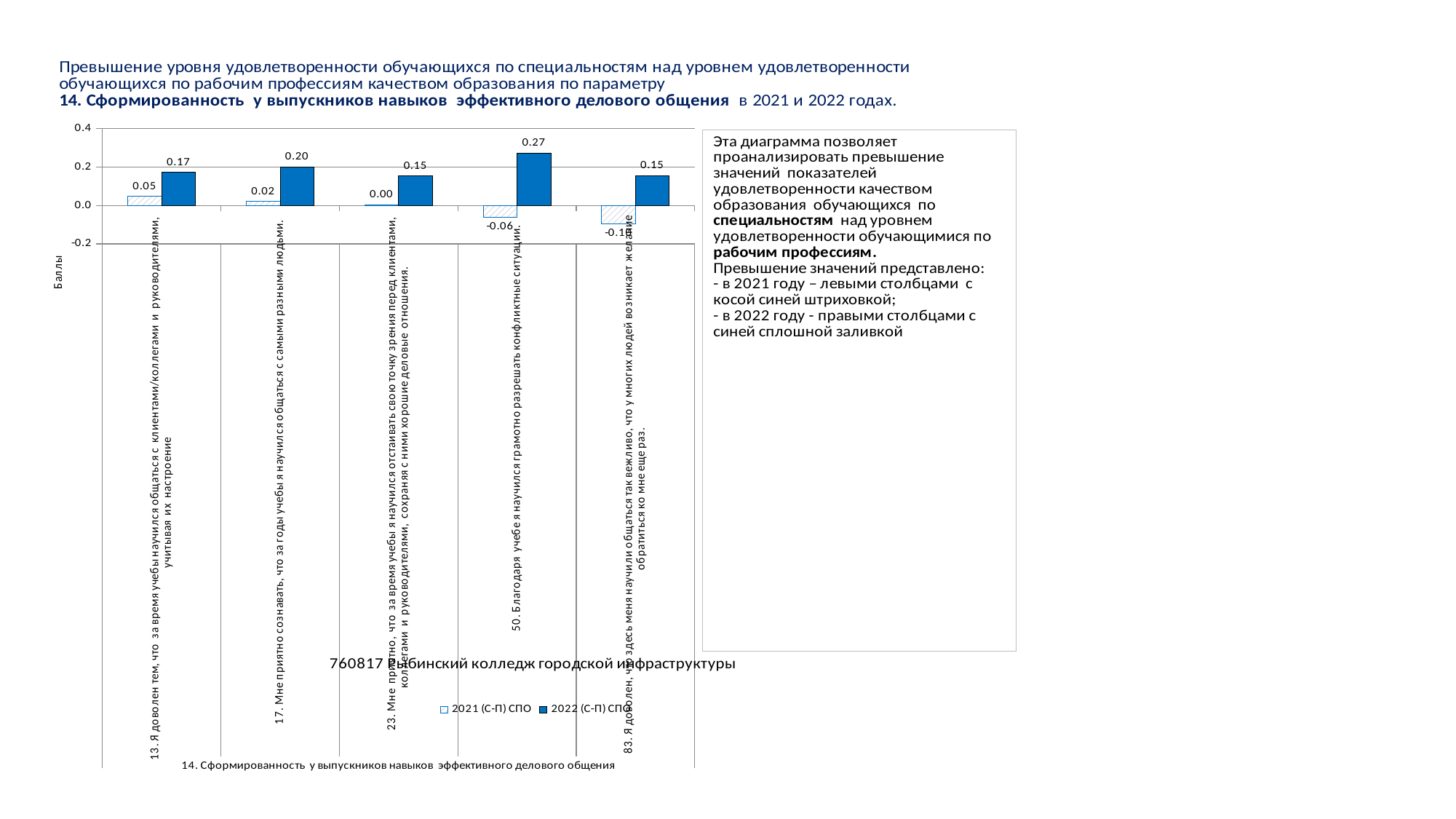
How many categories (statements) are plotted on the x axis of the chart? 5 What is the difference between the 2022 and 2021 values for statement 50? 0.33 Which statement has the lowest 2022 (С-П) СПО value? 23 and 83 (both 0.15) Which is larger for statement 17: the 2021 (С-П) СПО value or the 2022 (С-П) СПО value? 2022 (С-П) СПО What is the 2021 (С-П) СПО value for statement 13 (Я доволен тем, что за время учебы научился общаться с клиентами/коллегами и руководителями)? 0.05 What type of chart is shown on the slide? bar chart What is the 2021 (С-П) СПО value for statement 23 (Мне приятно, что за время учебы я научился отстаивать свою точку зрения перед клиентами)? 0.00 What is the 2022 (С-П) СПО value for statement 50 (Благодаря учебе я научился грамотно разрешать конфликтные ситуации)? 0.27 How many series does the chart legend list? 2 What is the 2022 (С-П) СПО value for statement 17 (Мне приятно сознавать, что за годы учебы я научился общаться с самыми разными людьми)? 0.20 Which statement has the highest 2022 (С-П) СПО value? 50. Благодаря учебе я научился грамотно разрешать конфликтные ситуации Which series is shown with a hatched (striped) fill in the chart? 2021 (С-П) СПО